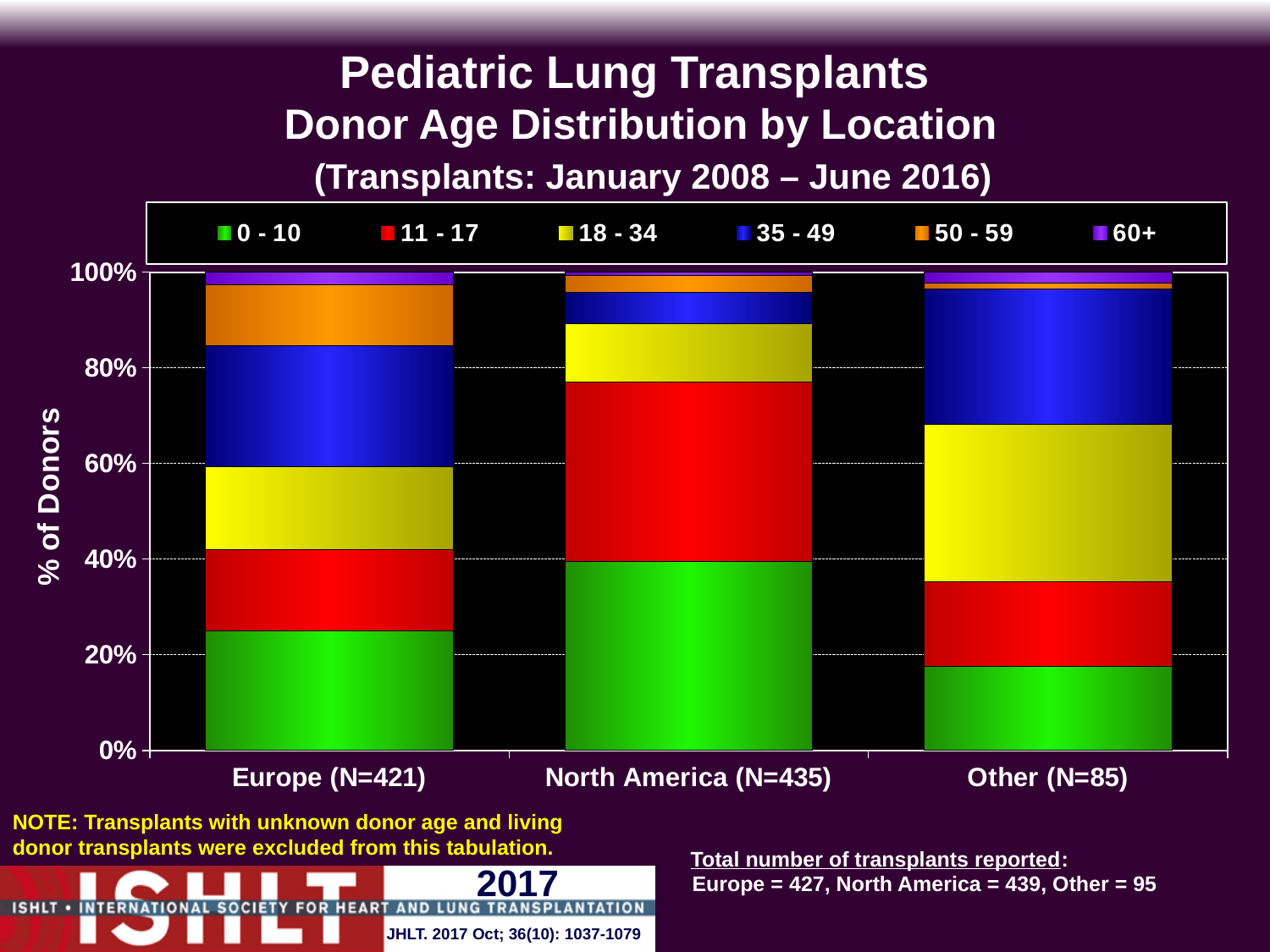
How many donor age groups does the legend list? 6 Is the share of donors aged 0 - 10 for Other greater or less than 20%? less What kind of chart is shown on the slide? stacked bar chart Is the share of donors aged 0 - 10 for Europe greater or less than 20%? greater Which has a larger share of donors aged 18 - 34: North America or Other? Other Which location has the smallest share of donors aged 0 - 10? Other (N=85) How many locations (categories) are shown on the x axis? 3 What is the label on the y axis? % of Donors Which location has the largest share of donors aged 11 - 17? North America (N=435) Which location has the largest share of donors aged 0 - 10? North America (N=435) What is the first age group listed in the legend? 0 - 10 Which has a larger share of donors aged 35 - 49: North America or Other? Other